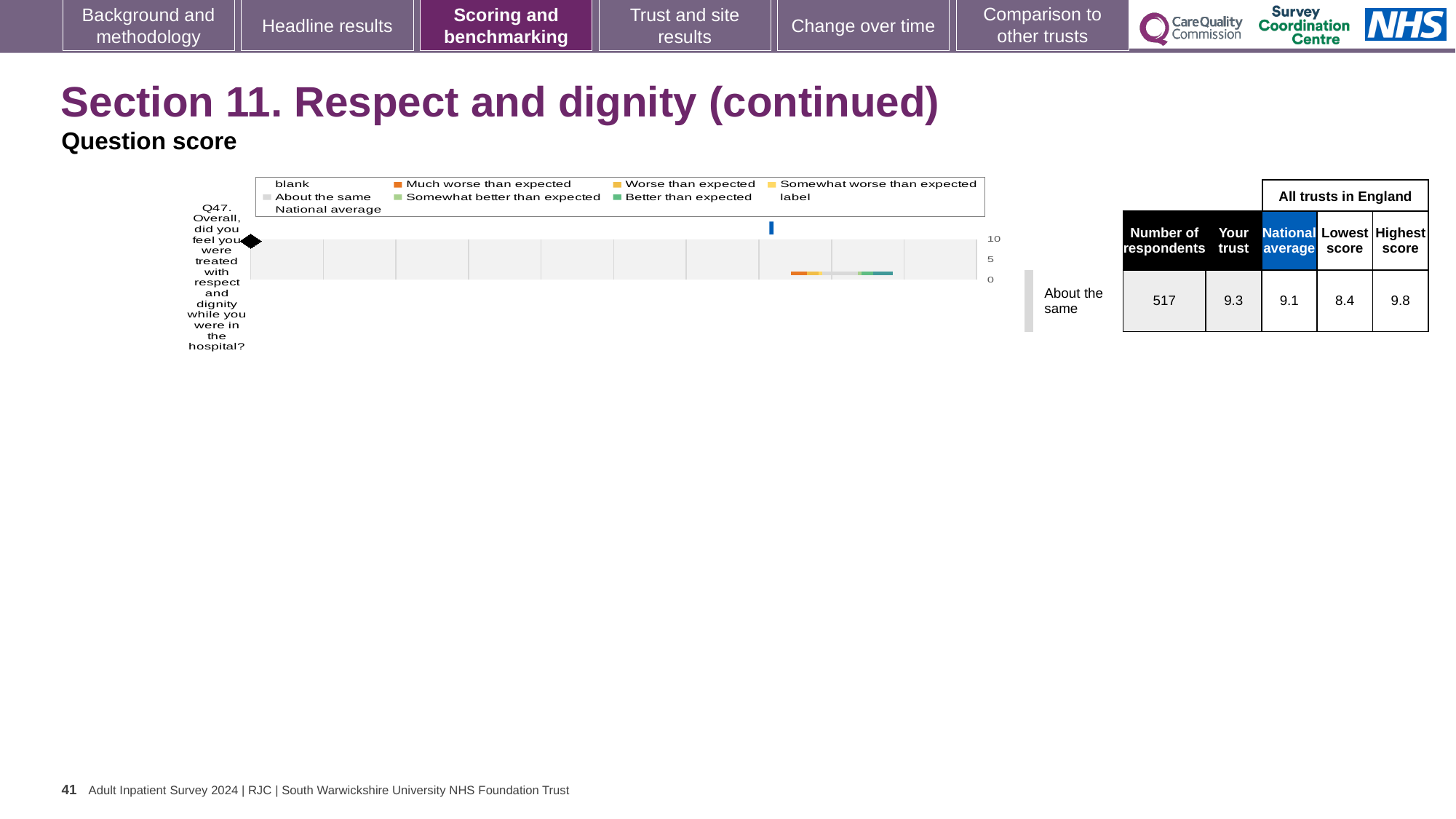
In the table beside the chart, what is the national average score for Q47? 9.1 What is the highest tick value shown on the chart's score axis? 10 What is the difference between the highest score and the lowest score for Q47? 1.4 What colour does the legend use for 'Much worse than expected'? orange In the table beside the chart, what is the lowest score among all trusts in England for Q47? 8.4 What kind of chart is shown on the slide? bar chart How many questions (categories) are plotted on the chart? 1 Which is larger for Q47, the 'Your trust' score or the national average? Your trust How many respondents are listed for Q47? 517 In the table beside the chart, what is the highest score among all trusts in England for Q47? 9.8 In the table beside the chart, what is the 'Your trust' score for Q47? 9.3 How many entries does the chart's legend list? 9